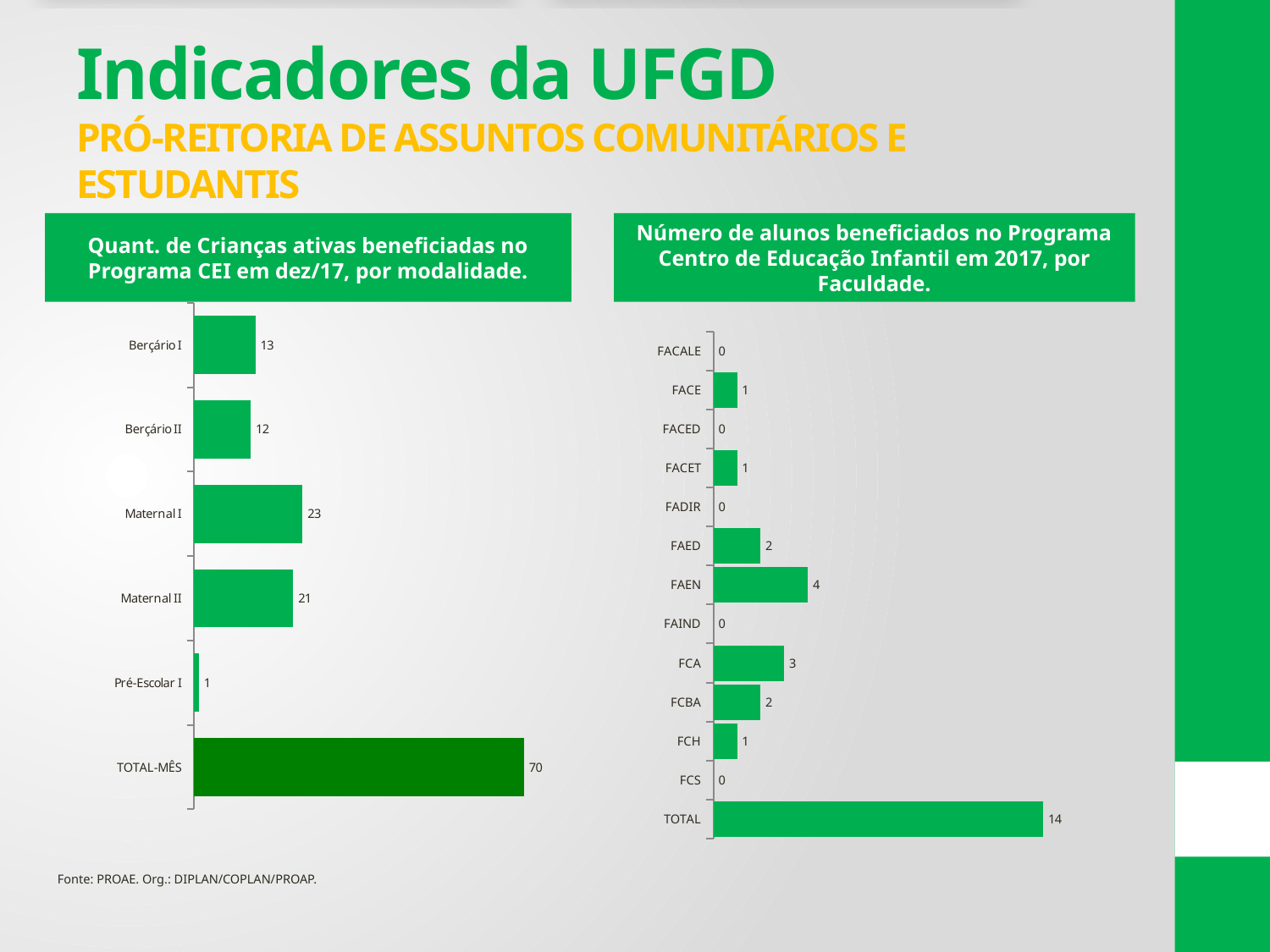
In the left chart (Quant. de Crianças ativas beneficiadas no Programa CEI em dez/17, por modalidade), which modality (excluding TOTAL-MÊS) has the highest value? Maternal I In the left chart (Quant. de Crianças ativas beneficiadas no Programa CEI em dez/17, por modalidade), what is the value of TOTAL-MÊS? 70 In the right chart (Número de alunos beneficiados no Programa Centro de Educação Infantil em 2017, por Faculdade), what is the value for FAEN? 4 In the left chart (Quant. de Crianças ativas beneficiadas no Programa CEI em dez/17, por modalidade), what is the value for Maternal I? 23 In the left chart (Quant. de Crianças ativas beneficiadas no Programa CEI em dez/17, por modalidade), what is the value for Pré-Escolar I? 1 In the right chart (Número de alunos beneficiados no Programa Centro de Educação Infantil em 2017, por Faculdade), what is the difference between FCA and FCBA? 1 In the right chart (Número de alunos beneficiados no Programa Centro de Educação Infantil em 2017, por Faculdade), which faculty (excluding TOTAL) has the highest value? FAEN In the left chart (Quant. de Crianças ativas beneficiadas no Programa CEI em dez/17, por modalidade), what is the difference between Berçário I and Berçário II? 1 In the left chart (Quant. de Crianças ativas beneficiadas no Programa CEI em dez/17, por modalidade), which is larger, Maternal I or Maternal II? Maternal I In the right chart (Número de alunos beneficiados no Programa Centro de Educação Infantil em 2017, por Faculdade), how many faculties have a value of 0? 5 In the right chart (Número de alunos beneficiados no Programa Centro de Educação Infantil em 2017, por Faculdade), what is the TOTAL value? 14 What type of chart is the right chart (Número de alunos beneficiados no Programa Centro de Educação Infantil em 2017, por Faculdade)? Bar chart